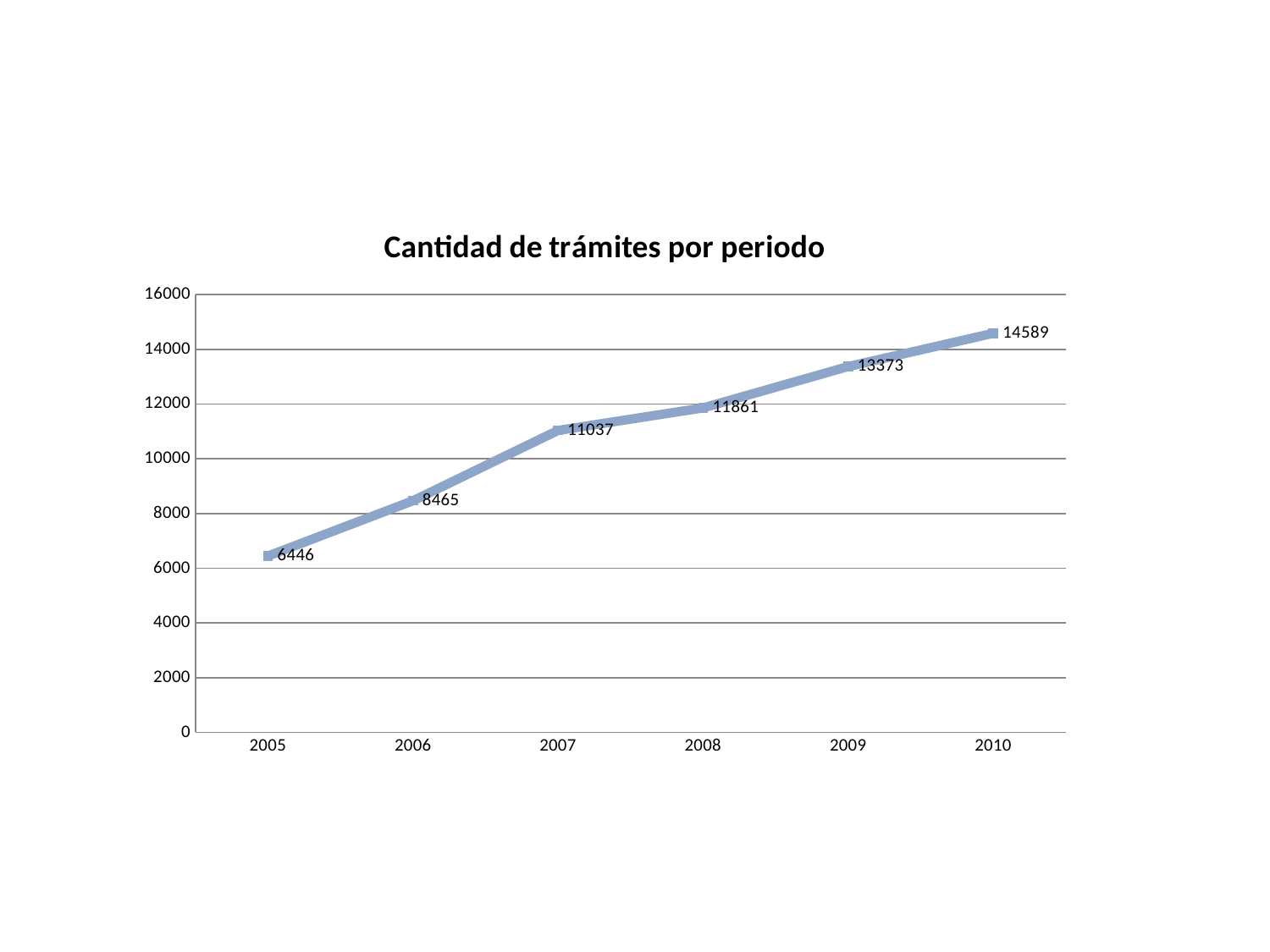
What is the difference between the values for 2010 and 2005? 8143 What is the value for 2005? 6446 Which year has the highest value? 2010 Which year has the lowest value? 2005 Which is larger, the value for 2008 or the value for 2009? 2009 What is the difference between the values for 2007 and 2006? 2572 What kind of chart is shown? line chart How many years are plotted on the chart? 6 What is the value for 2010? 14589 Do the values rise or fall from 2005 to 2010? rise What is the value for 2007? 11037 Is the value for 2006 greater or less than 8000? greater